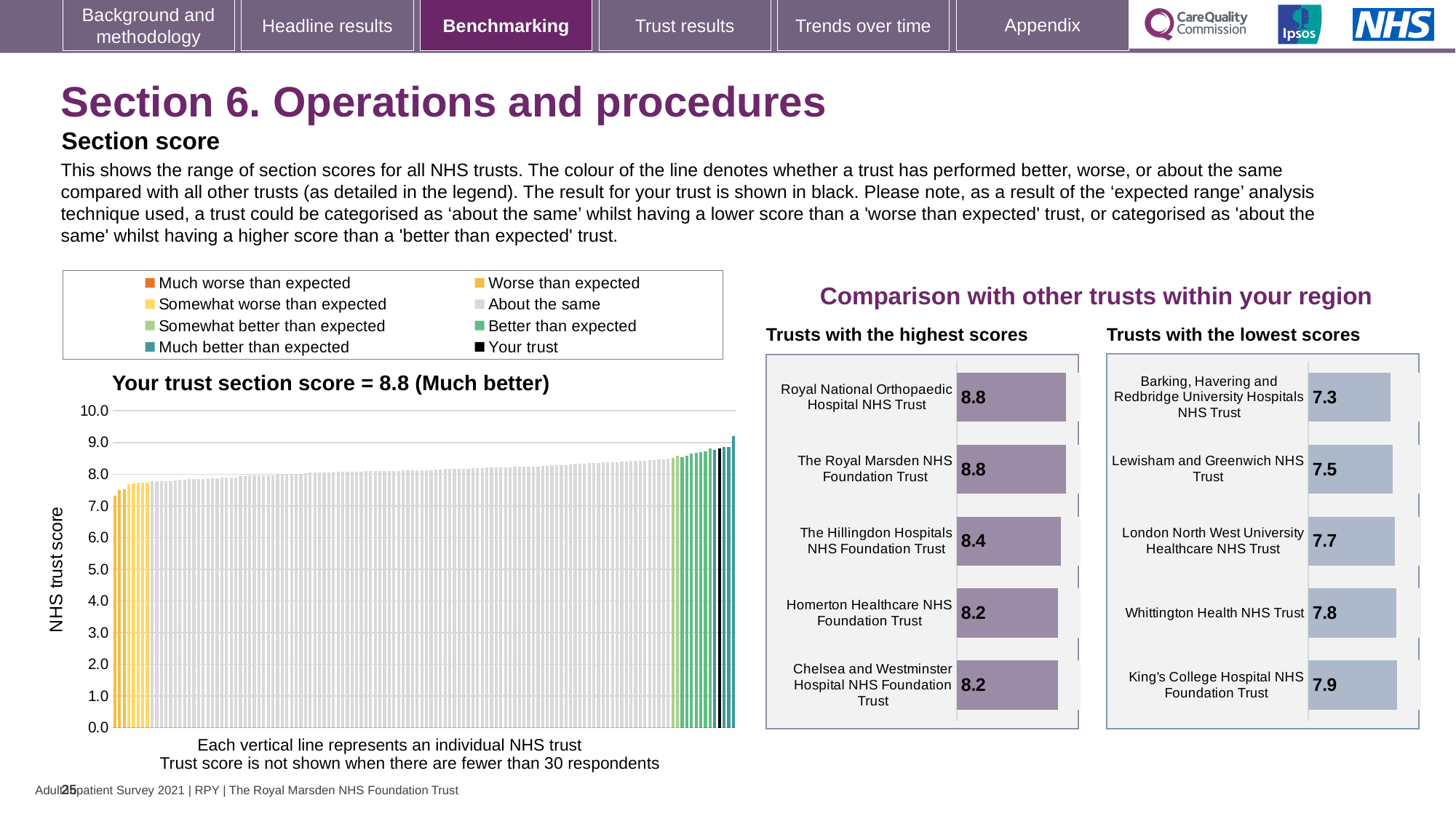
In the 'Trusts with the lowest scores' chart, which trust has the lowest score? Barking, Havering and Redbridge University Hospitals NHS Trust In the 'Trusts with the highest scores' chart, what is the score for The Hillingdon Hospitals NHS Foundation Trust? 8.4 How many entries does the legend above the 'Your trust section score' chart list? 8 How many trusts are listed in the 'Trusts with the highest scores' chart? 5 In the 'Trusts with the lowest scores' chart, what is the score for Lewisham and Greenwich NHS Trust? 7.5 In the 'Your trust section score' chart on the left, do the bars rise or fall from left to right? Rise According to the title of the chart on the left, what is your trust's section score? 8.8 What kind of chart is the 'Your trust section score' chart on the left? Bar chart In the 'Trusts with the lowest scores' chart, which has the higher score: Whittington Health NHS Trust or London North West University Healthcare NHS Trust? Whittington Health NHS Trust What is the y-axis label of the 'Your trust section score' chart on the left? NHS trust score In the 'Trusts with the highest scores' chart, what is the difference between the score for The Royal Marsden NHS Foundation Trust and the score for Homerton Healthcare NHS Foundation Trust? 0.6 In the 'Trusts with the lowest scores' chart, what is the difference between the score for King's College Hospital NHS Foundation Trust and the score for Barking, Havering and Redbridge University Hospitals NHS Trust? 0.6